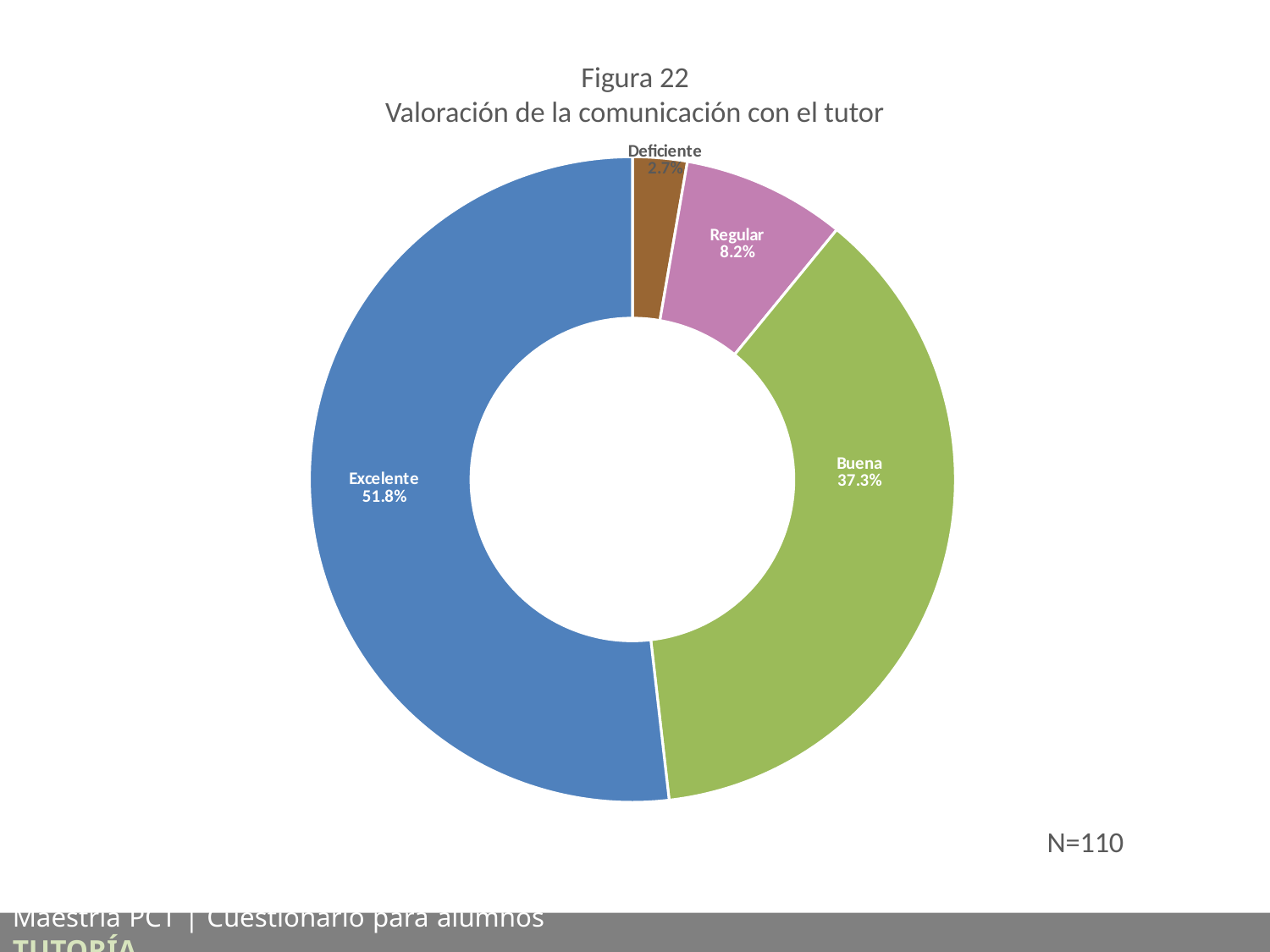
What sample size (N) is stated on the slide? N=110 What percentage is shown for the Regular category? 8.2% Which category has the largest share of the chart? Excelente What is the title of the chart? Figura 22 Valoración de la comunicación con el tutor Which category has the smallest share of the chart? Deficiente What percentage of respondents rated communication with the tutor as Excelente? 51.8% What percentage is shown for the Buena category? 37.3% What is the difference in percentage points between Excelente and Buena? 14.5 Which is larger, the share for Regular or the share for Deficiente? Regular What percentage is shown for the Deficiente category? 2.7% What kind of chart is shown on the slide? Pie chart (doughnut) How many categories are shown in the chart? 4